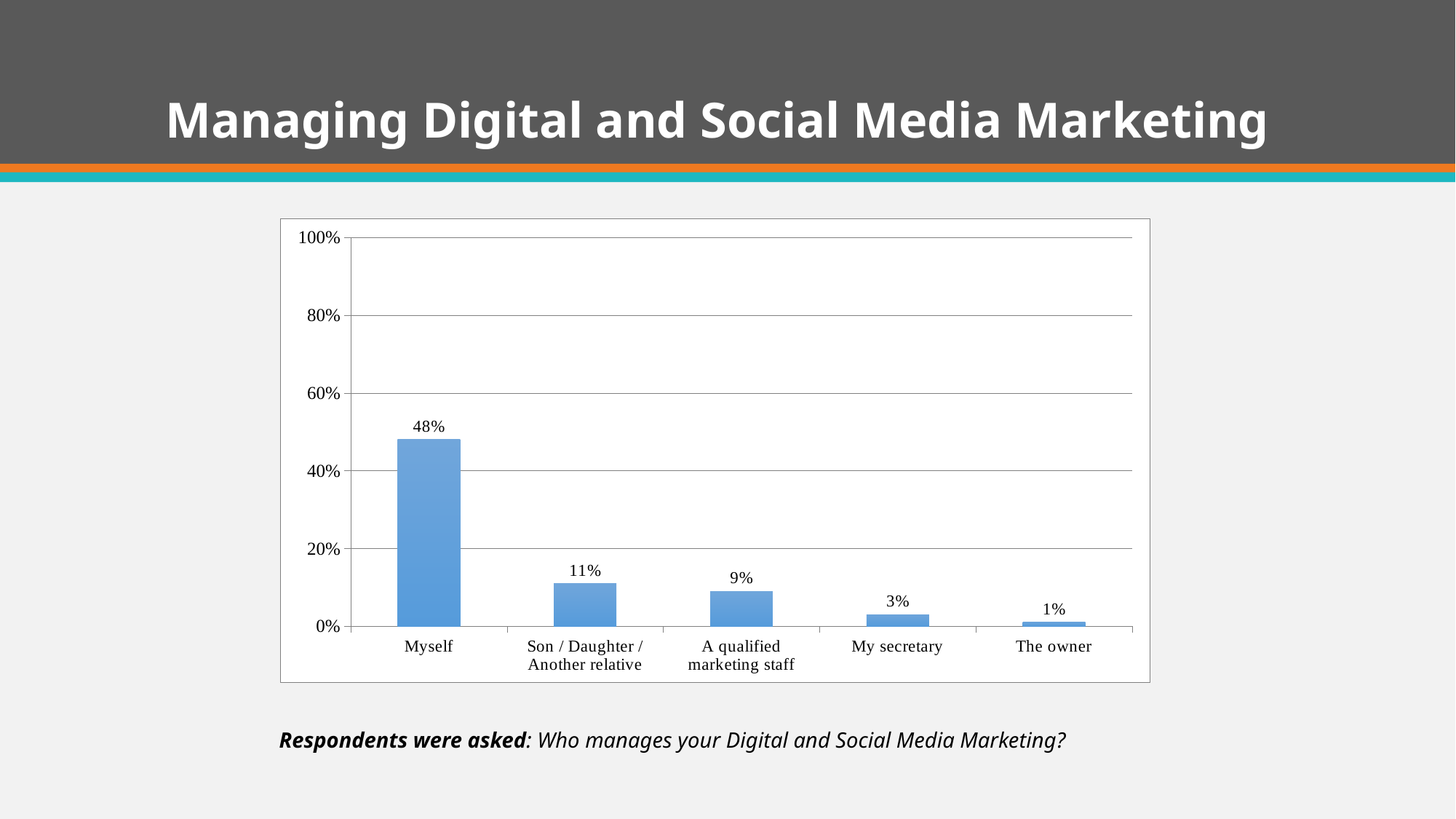
How many categories are shown on the x axis? 5 Which is larger, the value for 'A qualified marketing staff' or the value for 'My secretary'? A qualified marketing staff Which category has the lowest value? The owner Which category has the highest value? Myself What is the value for 'Son / Daughter / Another relative'? 11% What percentage of respondents said they manage their Digital and Social Media Marketing themselves (Myself)? 48% What kind of chart is shown on the slide? Bar chart What is the value for 'A qualified marketing staff'? 9% What is the difference between the values for 'Myself' and 'Son / Daughter / Another relative'? 37% Is the value for 'Myself' greater or less than 40%? greater What is the value for 'My secretary'? 3% What is the value for 'The owner'? 1%